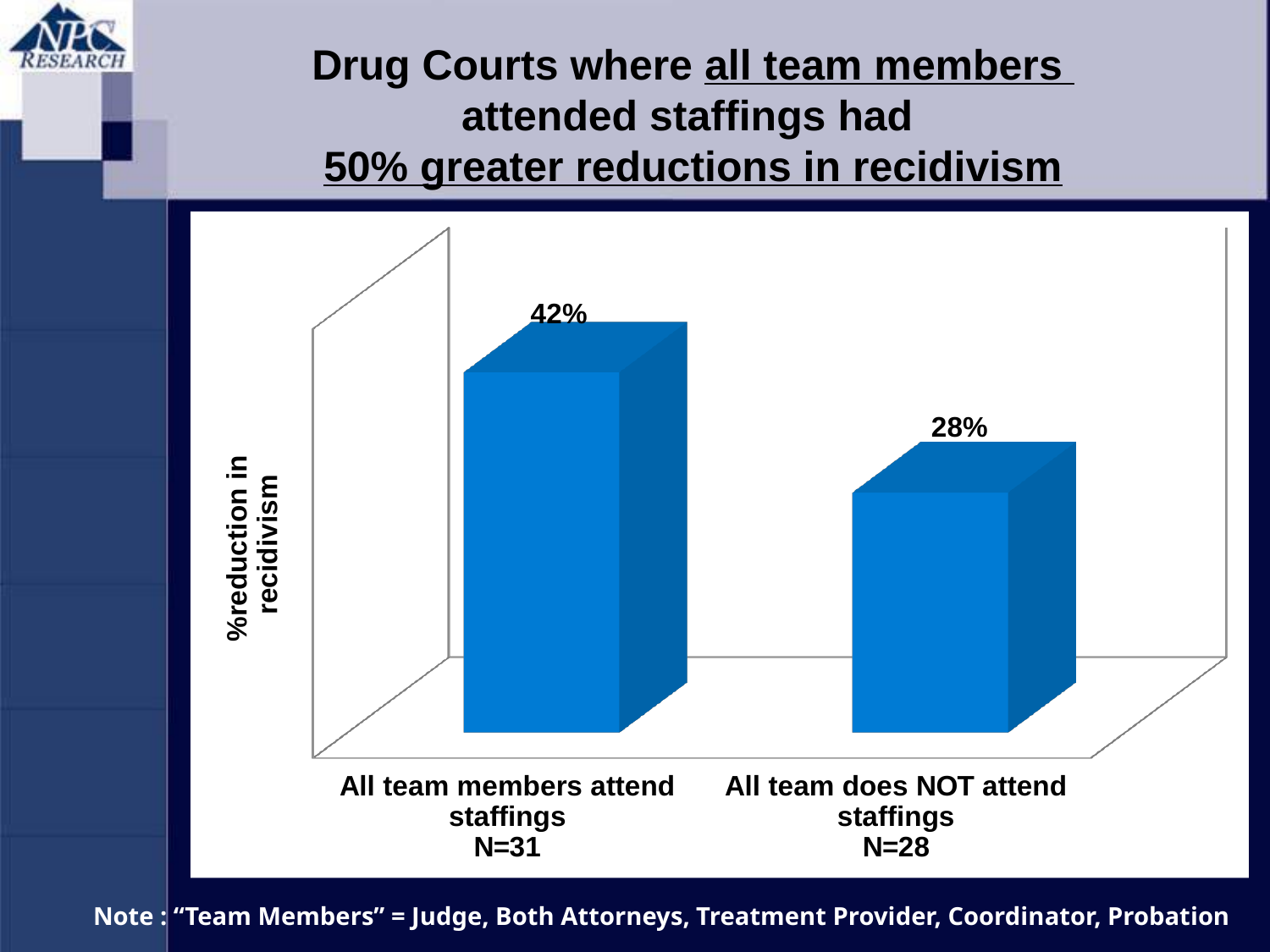
Is the % reduction in recidivism larger for courts where all team members attend staffings or for courts where all team does NOT attend staffings? All team members attend staffings How many categories are shown in the bar chart? 2 Which category has the higher % reduction in recidivism? All team members attend staffings What is the difference in % reduction in recidivism between courts where all team members attend staffings and those where all team does NOT attend? 14% What is the sample size (N) for the category where all team members attend staffings? N=31 What is the label of the vertical axis of the chart? % reduction in recidivism What kind of chart is shown on the slide? Bar chart What is the % reduction in recidivism for drug courts where all team members attend staffings? 42% What is the % reduction in recidivism for drug courts where all team does NOT attend staffings? 28% Which category has the lower % reduction in recidivism? All team does NOT attend staffings